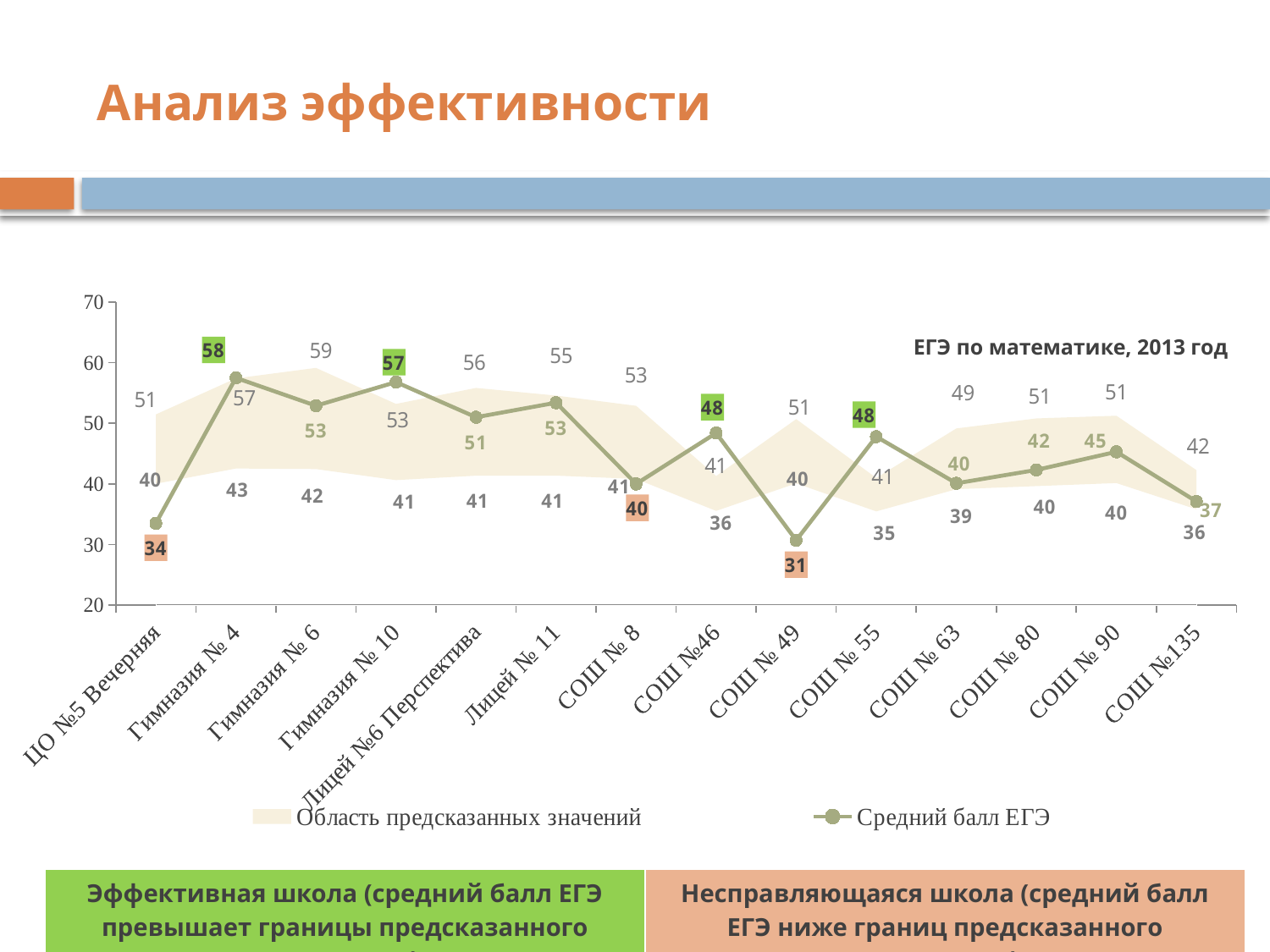
What is the average ЕГЭ score (Средний балл ЕГЭ) for Гимназия № 4? 58 How many entries does the chart legend list? 2 What is the average ЕГЭ score (Средний балл ЕГЭ) for СОШ № 90? 45 How many schools are shown on the x axis of the chart? 14 What is the average ЕГЭ score (Средний балл ЕГЭ) for СОШ № 49? 31 Which has a higher average ЕГЭ score, Гимназия № 10 or Лицей № 11? Гимназия № 10 What is the difference between the average ЕГЭ scores of Гимназия № 4 and ЦО №5 Вечерняя? 24 What type of chart is used to show the average ЕГЭ scores? line chart Which school has the highest average ЕГЭ score on the chart? Гимназия № 4 Is the average ЕГЭ score for СОШ №46 greater or less than 40? greater Which school has the lowest average ЕГЭ score on the chart? СОШ № 49 What title is printed inside the chart area? ЕГЭ по математике, 2013 год